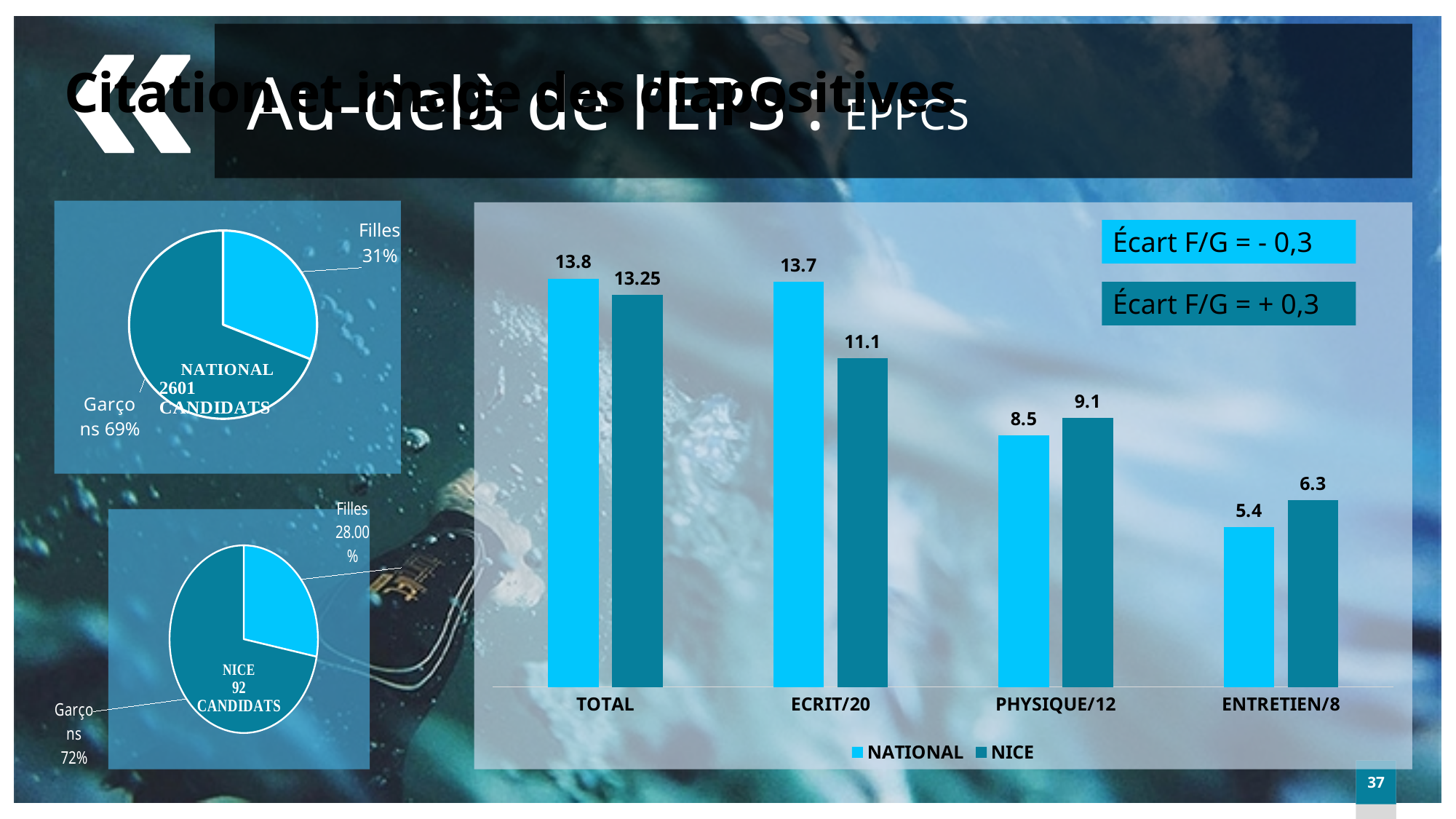
What kind of chart is the NATIONAL 2601 CANDIDATS chart at the top left? Pie chart In the bar chart on the right, which is larger for PHYSIQUE/12: NATIONAL or NICE? NICE In the bar chart on the right, how many series does the legend list? 2 In the bar chart on the right, what is the NATIONAL value for ECRIT/20? 13.7 In the bar chart on the right, which category has the highest NICE value? TOTAL In the bar chart on the right, what is the NICE value for TOTAL? 13.25 In the bar chart on the right, what is the NICE value for ENTRETIEN/8? 6.3 In the NATIONAL 2601 CANDIDATS pie chart, what share is Filles? 31% In the bar chart on the right, how many categories are shown on the x axis? 4 In the bar chart on the right, which category has the lowest NATIONAL value? ENTRETIEN/8 In the NICE 92 CANDIDATS pie chart, what share is Garçons? 72% In the bar chart on the right, what is the difference between the NATIONAL and NICE values for ECRIT/20? 2.6